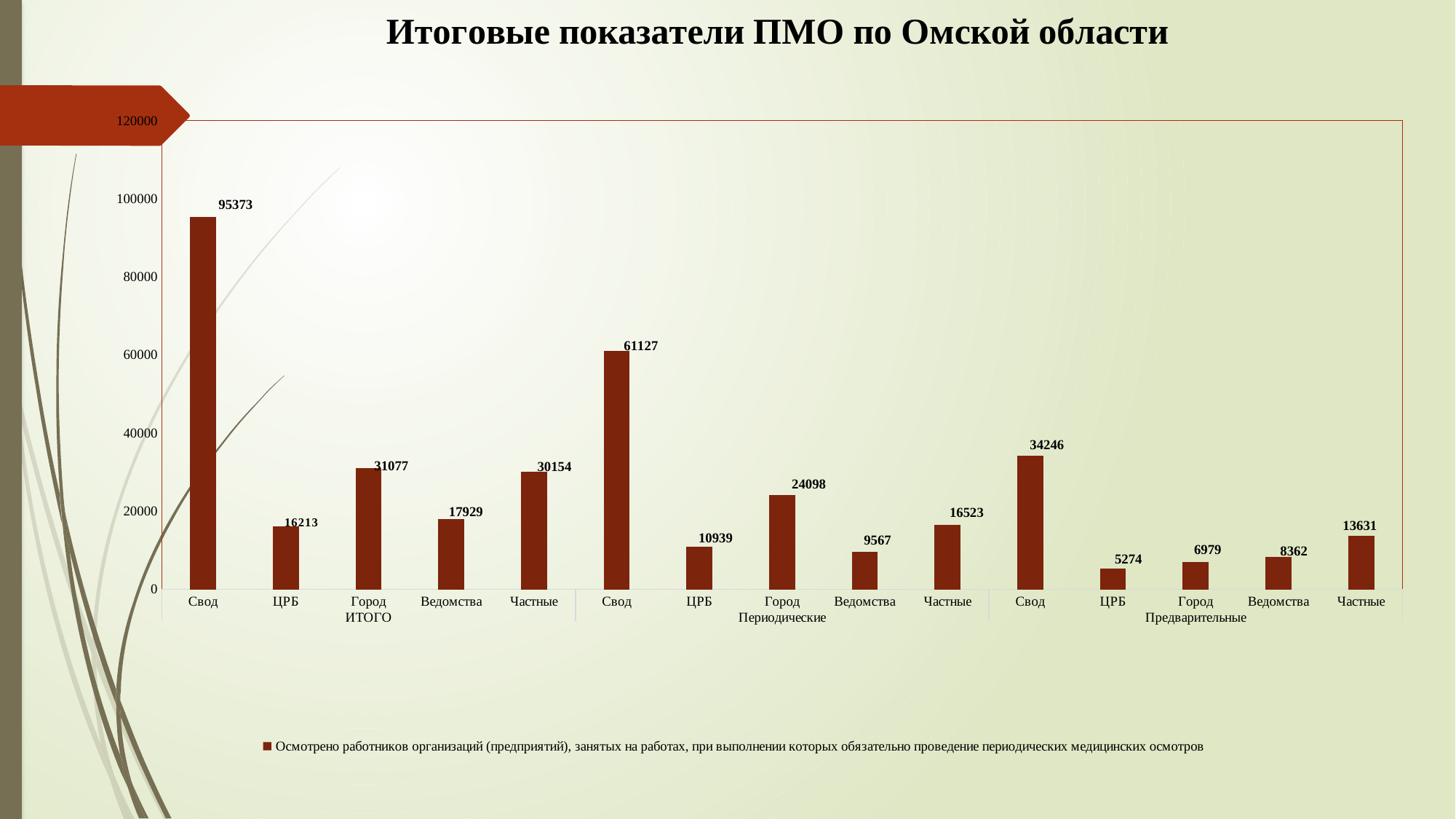
What is the value for ЦРБ in the Предварительные group? 5274 Which bar has the lowest value on the chart? ЦРБ (Предварительные) How many series does the legend list? 1 What is the difference between Свод in the Периодические group and Свод in the Предварительные group? 26881 How many bars are plotted on the chart? 15 What kind of chart is shown on the slide? bar chart Is the value for Ведомства in the ИТОГО group greater or less than 20000? less Which is larger: Город in the ИТОГО group or Частные in the ИТОГО group? Город (ИТОГО) What is the value for Город in the Периодические group? 24098 Which bar has the highest value on the chart? Свод (ИТОГО) What is the title of the slide? Итоговые показатели ПМО по Омской области What is the value for Свод in the ИТОГО group? 95373